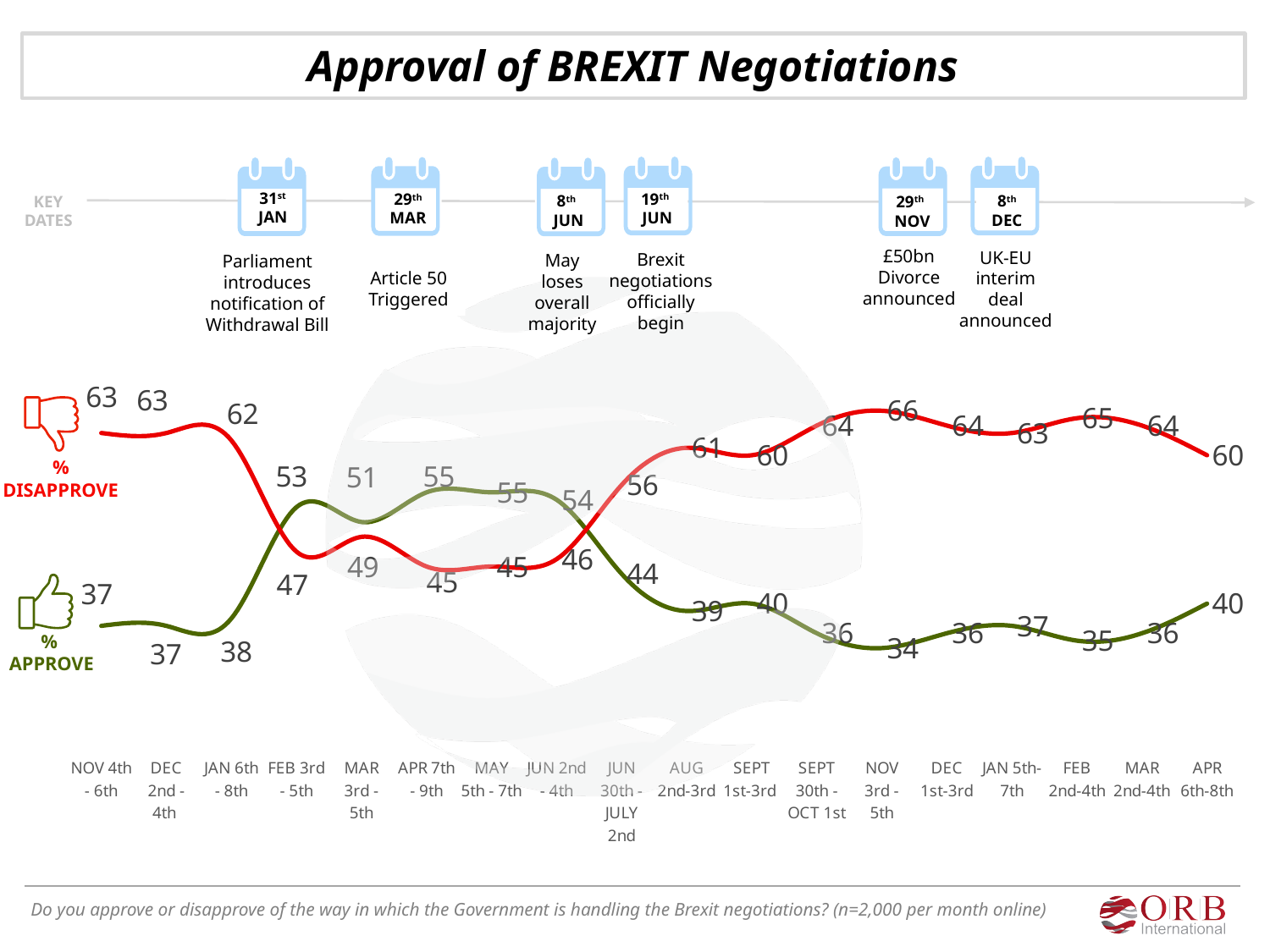
What type of chart is shown on the slide? Line chart How many series does the chart show? 2 What is the difference between % DISAPPROVE and % APPROVE for NOV 3rd - 5th? 32 What is the % DISAPPROVE value for APR 6th-8th? 60 Does % APPROVE rise or fall between JUN 2nd - 4th and AUG 2nd-3rd? Fall How many survey periods are shown on the x axis? 18 In which survey period does % APPROVE reach its lowest value? NOV 3rd - 5th What is the % DISAPPROVE value for NOV 4th - 6th? 63 What is the % APPROVE value for FEB 3rd - 5th? 53 In which survey period does % DISAPPROVE reach its highest value? NOV 3rd - 5th Which is larger for APR 7th - 9th, % APPROVE or % DISAPPROVE? % APPROVE What is the title of the chart? Approval of BREXIT Negotiations